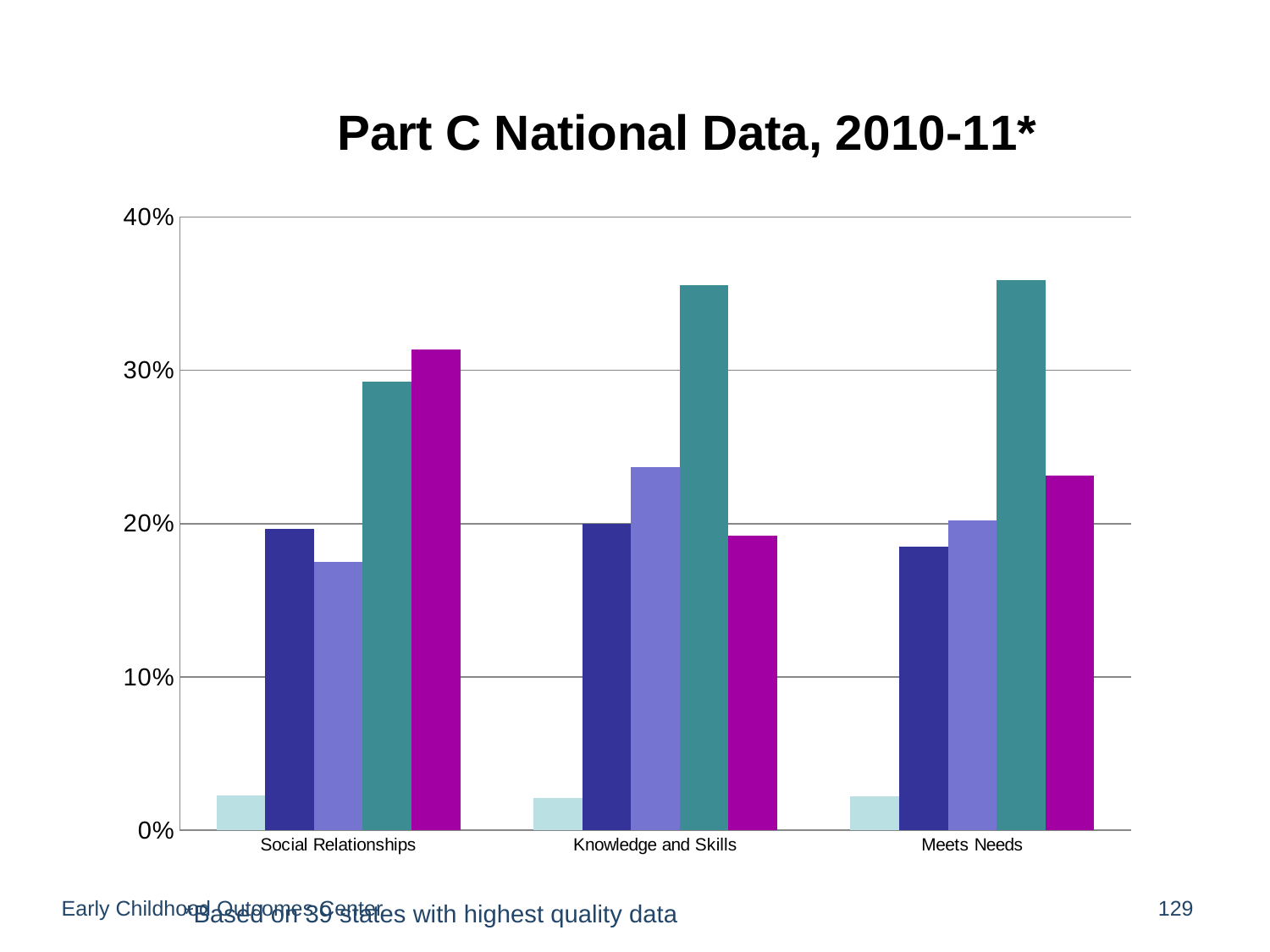
What kind of chart is shown on the slide? bar chart How many bars are plotted for each category? 5 Is the teal bar for Knowledge and Skills greater or less than 30%? greater Which bar is the shortest in the Meets Needs category? the light blue bar Is the light blue bar for Social Relationships greater or less than 10%? less Which bar is the tallest in the Social Relationships category? the magenta bar What is the title of the chart? Part C National Data, 2010-11* How many categories are shown on the x axis? 3 Is the dark blue bar for Meets Needs greater or less than 20%? less Which bar is the tallest in the Knowledge and Skills category? the teal bar Which is larger: the magenta bar for Social Relationships or the magenta bar for Meets Needs? Social Relationships